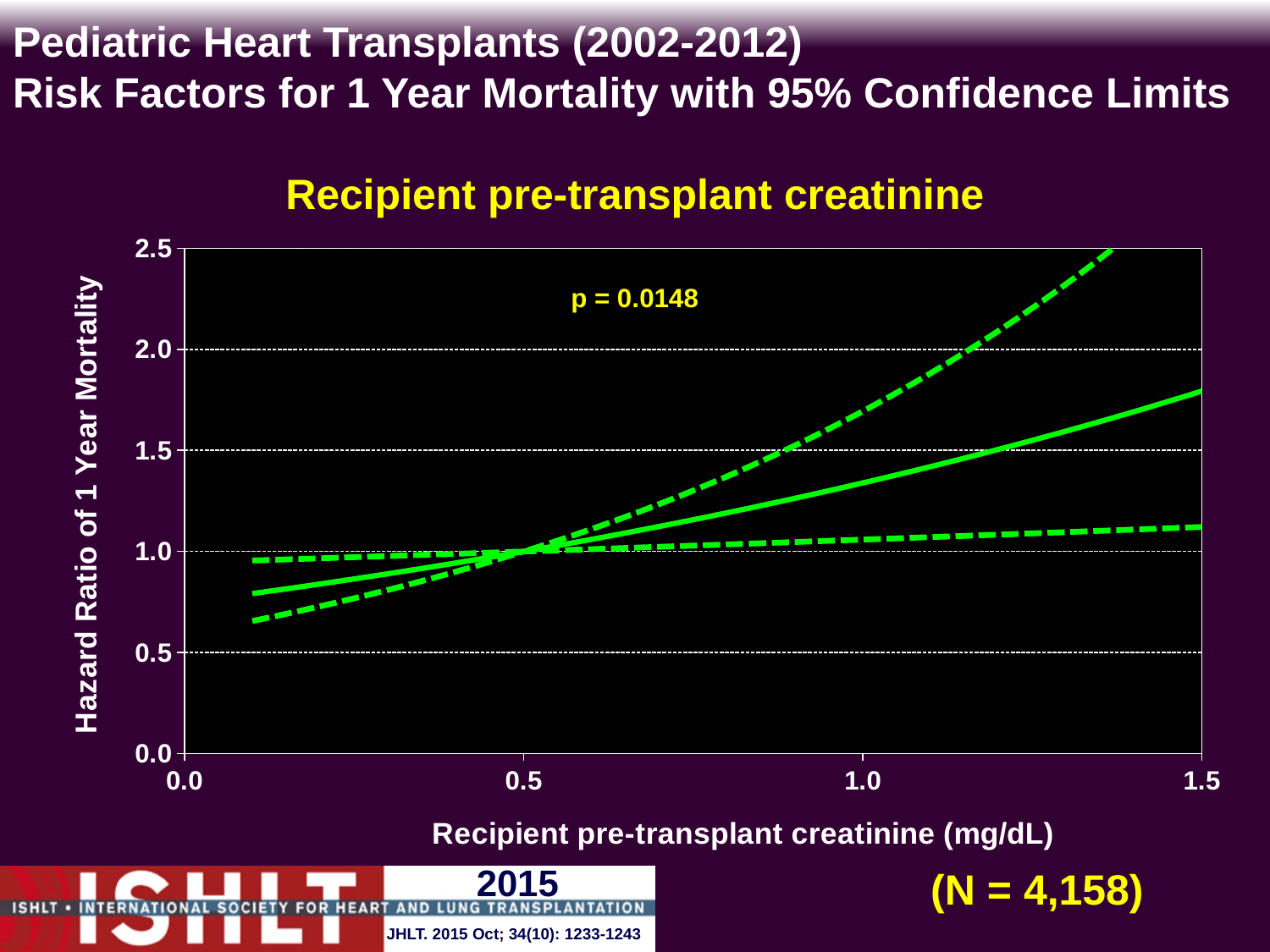
What is the title of the chart? Recipient pre-transplant creatinine What p-value is printed on the chart? p = 0.0148 What kind of chart is shown on the slide? Line chart How many lines are plotted on the chart? 3 Is the hazard ratio on the solid line at the lowest plotted creatinine (about 0.1 mg/dL) greater or less than 1.0? less Is the upper dashed confidence limit at a creatinine of 1.3 mg/dL greater or less than 2.0? greater Does the hazard ratio of 1 year mortality rise or fall as recipient pre-transplant creatinine increases? Rises What is the N shown on the slide? N = 4,158 Is the hazard ratio on the solid line at a creatinine of 1.5 mg/dL greater or less than 1.5? greater What is the label of the y axis? Hazard Ratio of 1 Year Mortality